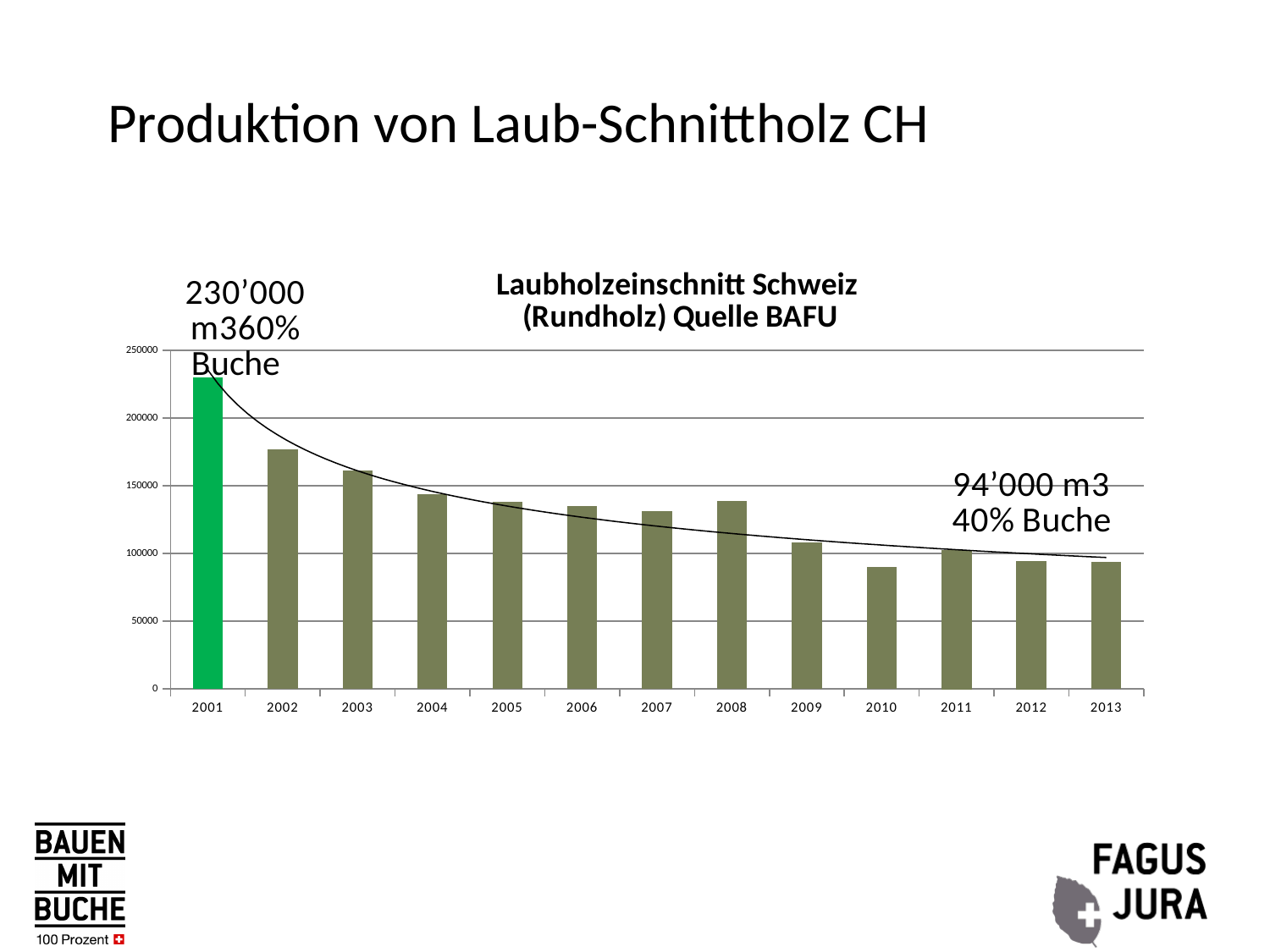
Is the value for 2002 greater or less than 150000? greater Which year has the highest value in the chart? 2001 Is the value for 2004 greater or less than 150000? less How many years are shown on the x axis of the chart? 13 What is the title of the chart? Laubholzeinschnitt Schweiz (Rundholz) Quelle BAFU What value is annotated for 2001 on the chart? 230'000 m3 Is the value for 2010 greater or less than 100000? less Which year has the larger value, 2002 or 2003? 2002 What kind of chart is shown on the slide? bar chart Do the values generally rise or fall from 2001 to 2013? fall Which year has the lowest value in the chart? 2010 What value is annotated for 2013 on the chart? 94'000 m3